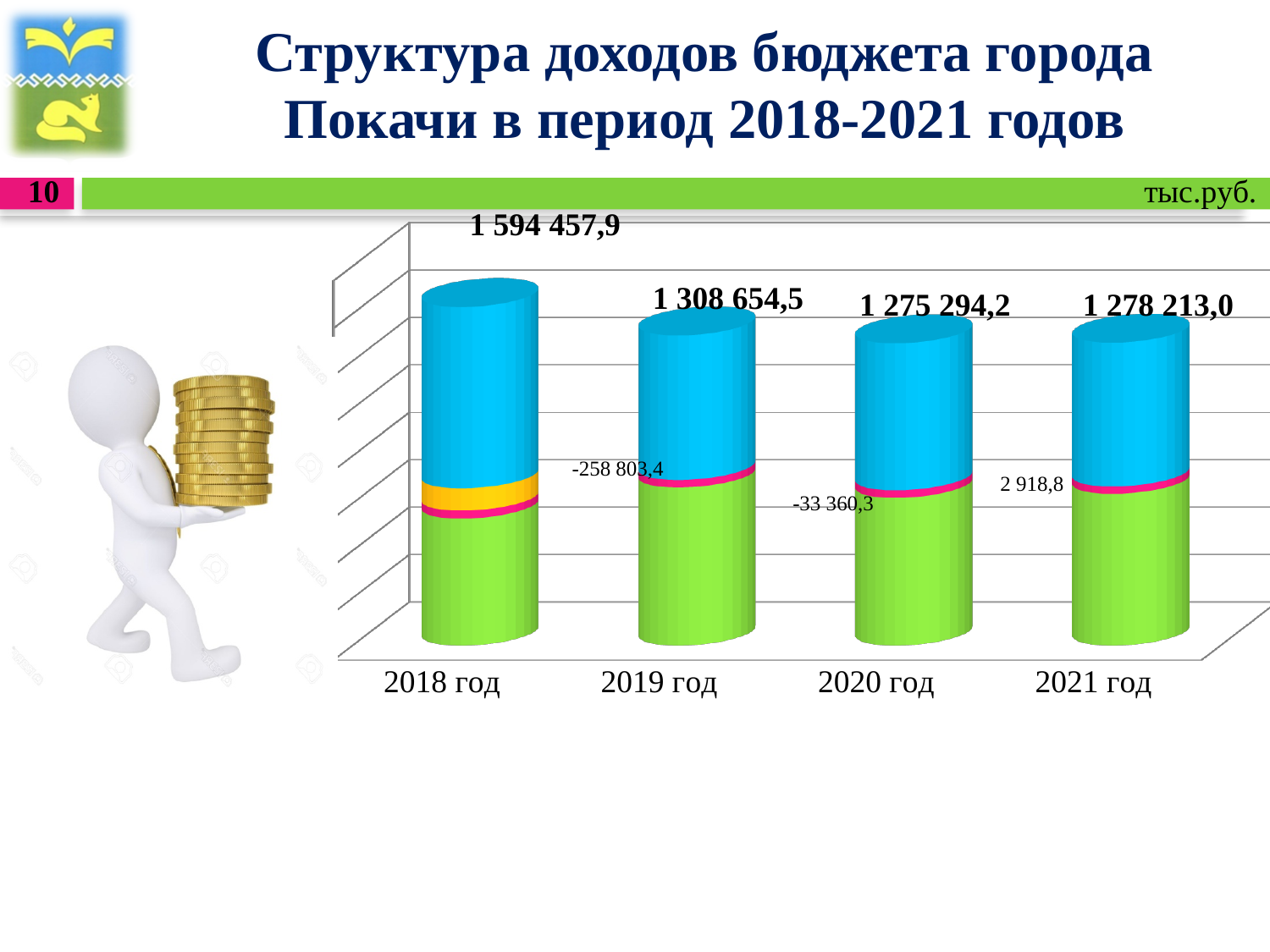
How many years are shown on the x axis? 4 Which year has the lowest total budget revenue? 2020 год What is the total budget revenue shown for 2019 год? 1 308 654,5 What is the total budget revenue shown for 2018 год? 1 594 457,9 What kind of chart is shown on the slide? Bar chart In what units are the values on the chart given? тыс.руб. Which year has the highest total budget revenue? 2018 год What is the difference between the totals for 2019 год and 2020 год? 33 360,3 What is the total budget revenue shown for 2020 год? 1 275 294,2 What is the total budget revenue shown for 2021 год? 1 278 213,0 What change value is printed next to the 2020 год bar? -33 360,3 Which is larger, the total for 2020 год or the total for 2021 год? 2021 год